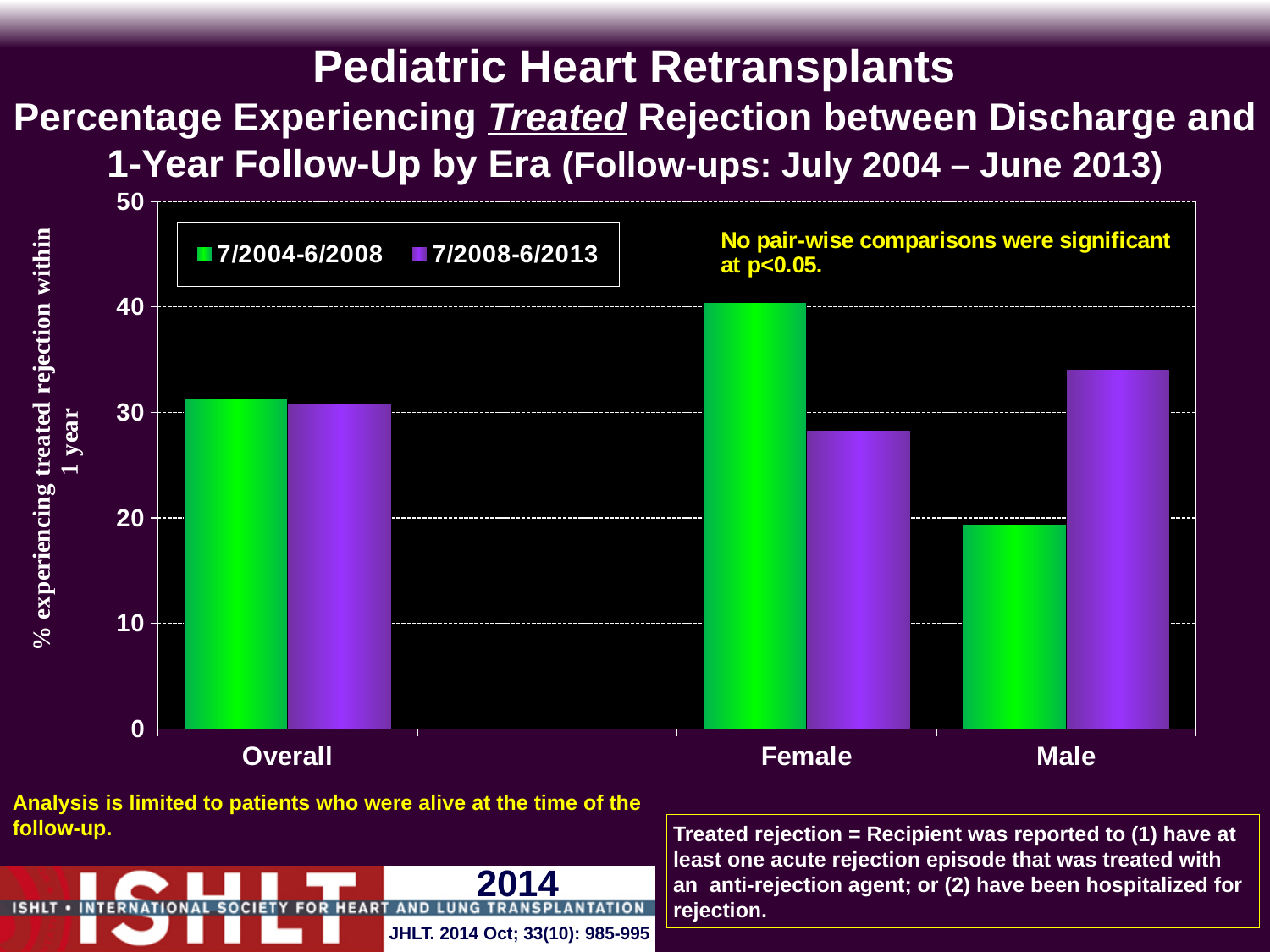
How many categories are shown on the x axis? 3 What are the two eras listed in the legend? 7/2004-6/2008 and 7/2008-6/2013 Which category has the lowest value for the 7/2004-6/2008 series? Male Is the value for Female in the 7/2008-6/2013 series greater or less than 30? less Is the value for Female in the 7/2004-6/2008 series greater or less than 30? greater For the Male category, which era has the larger value, 7/2004-6/2008 or 7/2008-6/2013? 7/2008-6/2013 Is the value for Male in the 7/2008-6/2013 series greater or less than 30? greater How many series does the legend list? 2 Which category has the highest value for the 7/2008-6/2013 series? Male What kind of chart is shown on the slide? bar chart Which category has the highest value for the 7/2004-6/2008 series? Female For the Female category, which era has the larger value, 7/2004-6/2008 or 7/2008-6/2013? 7/2004-6/2008